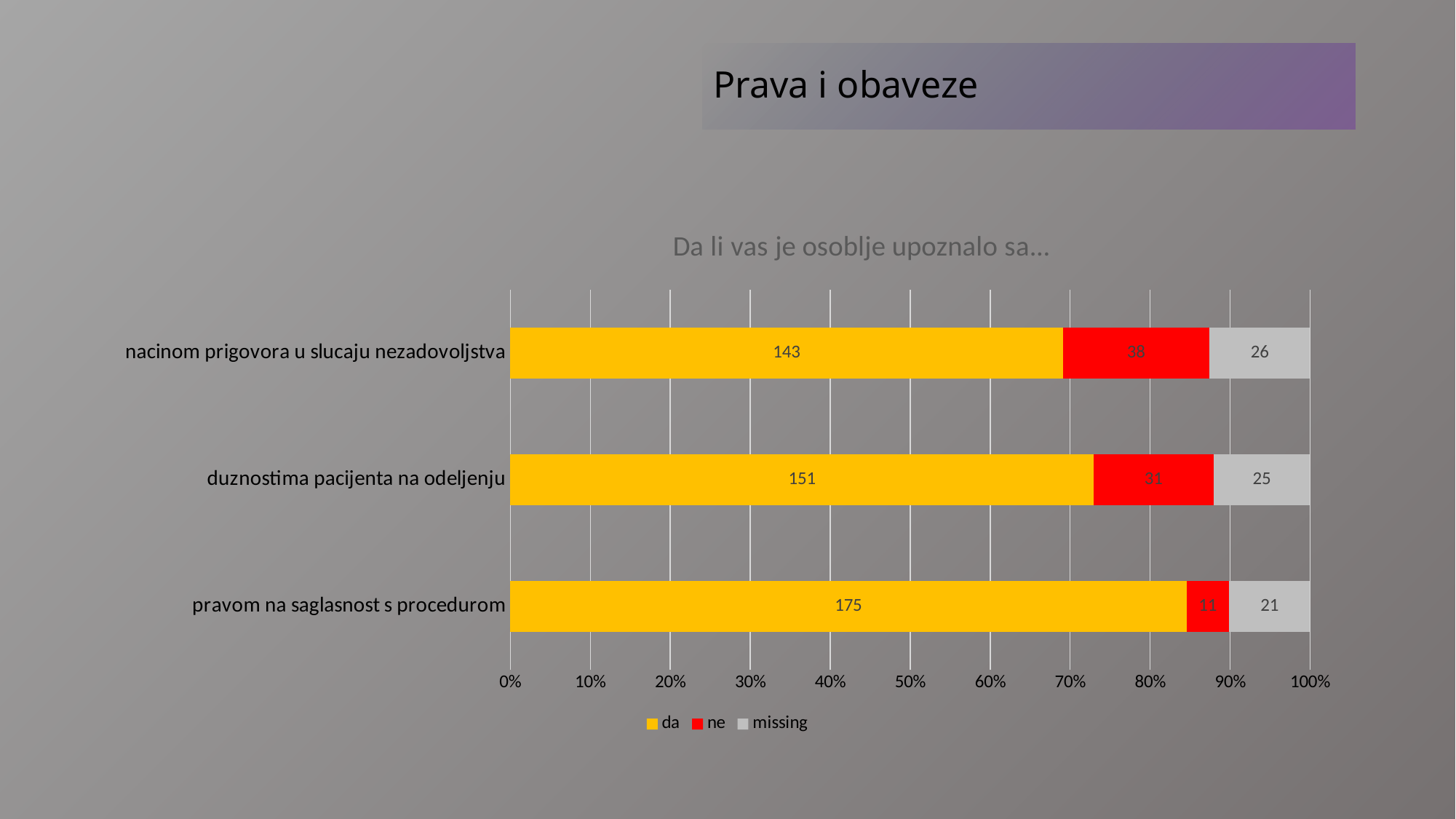
What is the difference between the 'da' values for 'duznostima pacijenta na odeljenju' and 'nacinom prigovora u slucaju nezadovoljstva'? 8 What kind of chart is shown on the slide? stacked bar chart What is the title of the chart? Da li vas je osoblje upoznalo sa... How many categories are shown on the chart? 3 What is the total of the three segments for 'nacinom prigovora u slucaju nezadovoljstva'? 207 Which is larger: the 'ne' value for 'duznostima pacijenta na odeljenju' or the 'ne' value for 'nacinom prigovora u slucaju nezadovoljstva'? nacinom prigovora u slucaju nezadovoljstva What is the 'da' value for 'pravom na saglasnost s procedurom'? 175 What is the 'ne' value for 'nacinom prigovora u slucaju nezadovoljstva'? 38 What is the 'missing' value for 'duznostima pacijenta na odeljenju'? 25 How many series does the legend list? 3 Which category has the lowest 'ne' value? pravom na saglasnost s procedurom Which category has the highest 'da' value? pravom na saglasnost s procedurom